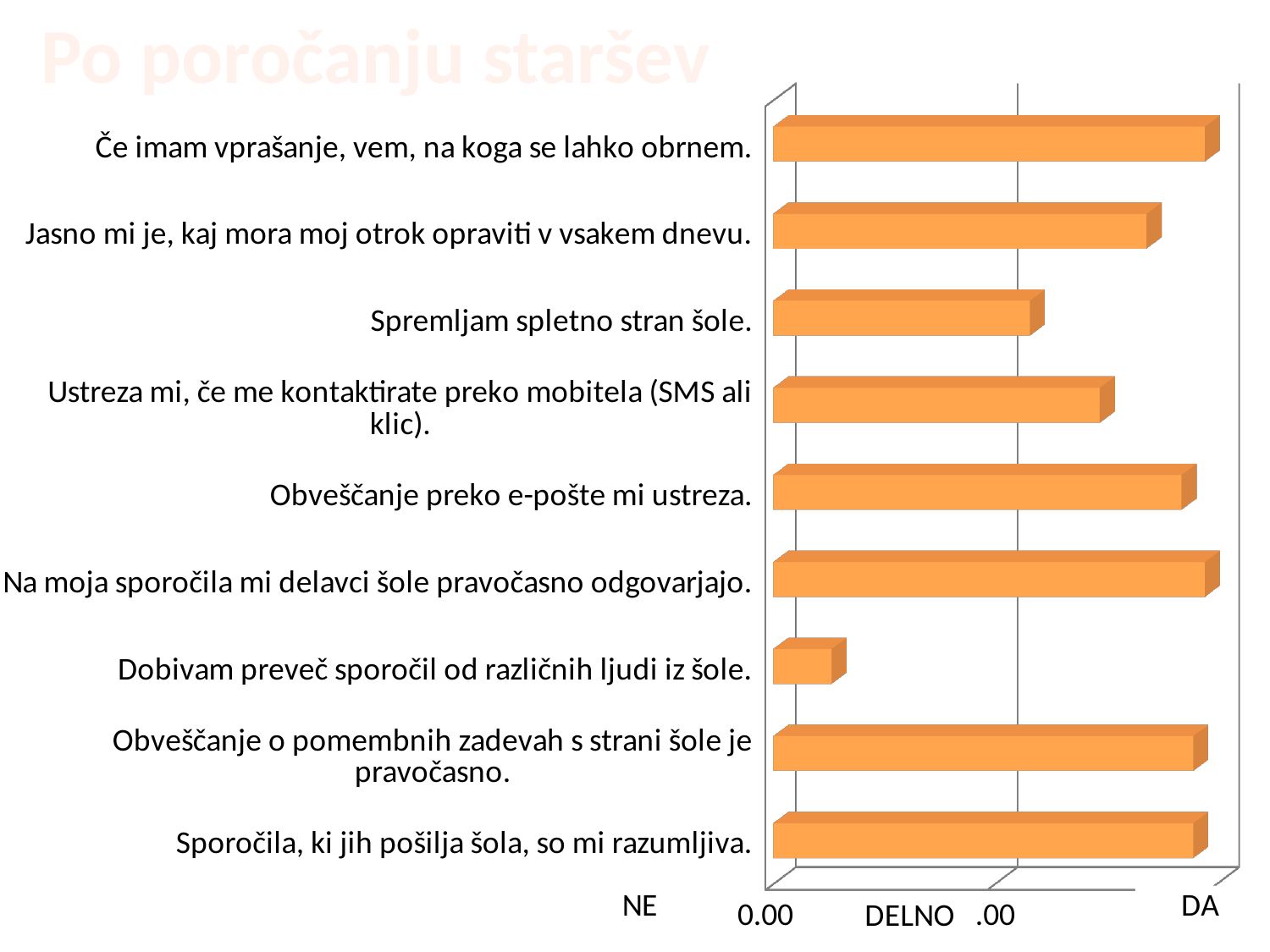
What kind of chart is shown on the slide? bar chart What three text labels appear along the horizontal axis of the chart? NE, DELNO, DA How many categories (statements) are plotted in the chart? 9 Which statement has the lowest value in the chart? Dobivam preveč sporočil od različnih ljudi iz šole. Which has the larger value: "Jasno mi je, kaj mora moj otrok opraviti v vsakem dnevu." or "Spremljam spletno stran šole."? Jasno mi je, kaj mora moj otrok opraviti v vsakem dnevu. Which has the larger value: "Dobivam preveč sporočil od različnih ljudi iz šole." or "Sporočila, ki jih pošilja šola, so mi razumljiva."? Sporočila, ki jih pošilja šola, so mi razumljiva. Which statement has the second-lowest value in the chart? Spremljam spletno stran šole. Which has the larger value: "Spremljam spletno stran šole." or "Obveščanje preko e-pošte mi ustreza."? Obveščanje preko e-pošte mi ustreza. What is the title of the slide? Po poročanju staršev